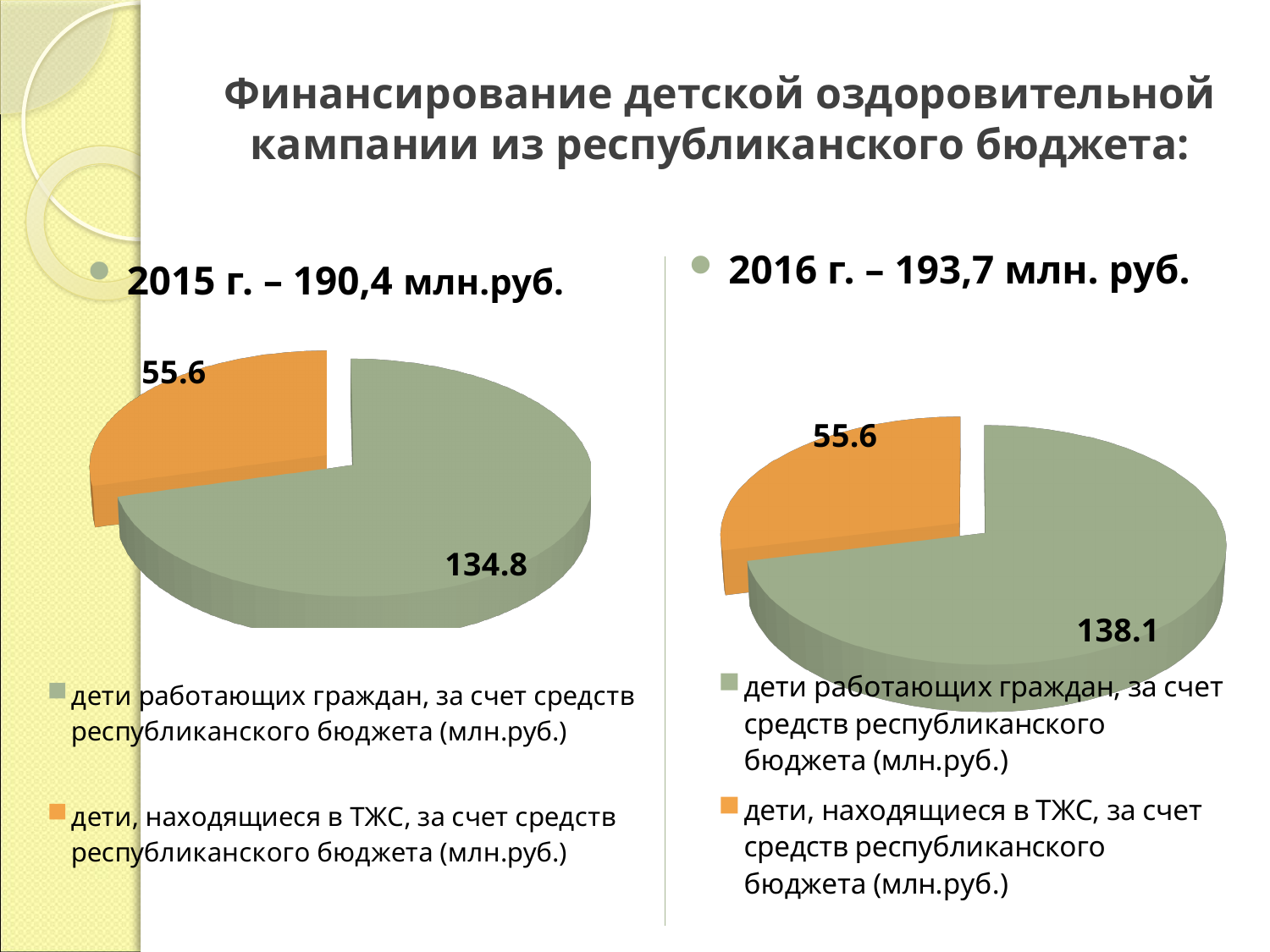
In the left pie chart (2015), what colour is the slice for children in difficult life situations (дети, находящиеся в ТЖС)? orange Is the value for children of working citizens larger in the left chart (2015) or the right chart (2016)? right chart (2016) In the left pie chart (2015), what is the value for children in difficult life situations (дети, находящиеся в ТЖС)? 55.6 What type of chart is used on the right side of the slide (2016)? pie chart In the right pie chart (2016), which category has the smallest slice? дети, находящиеся в ТЖС, за счет средств республиканского бюджета (млн.руб.) How many slices does the left pie chart (2015) have? 2 In the right pie chart (2016), what is the difference between the two slice values? 82.5 In the left pie chart (2015), what is the difference between the two slice values? 79.2 In the left pie chart (2015), which category has the largest slice? дети работающих граждан, за счет средств республиканского бюджета (млн.руб.) In the right pie chart (2016), what is the value for children of working citizens (дети работающих граждан)? 138.1 In the right pie chart (2016), what is the value for children in difficult life situations (дети, находящиеся в ТЖС)? 55.6 In the left pie chart (2015), what is the value for children of working citizens (дети работающих граждан)? 134.8